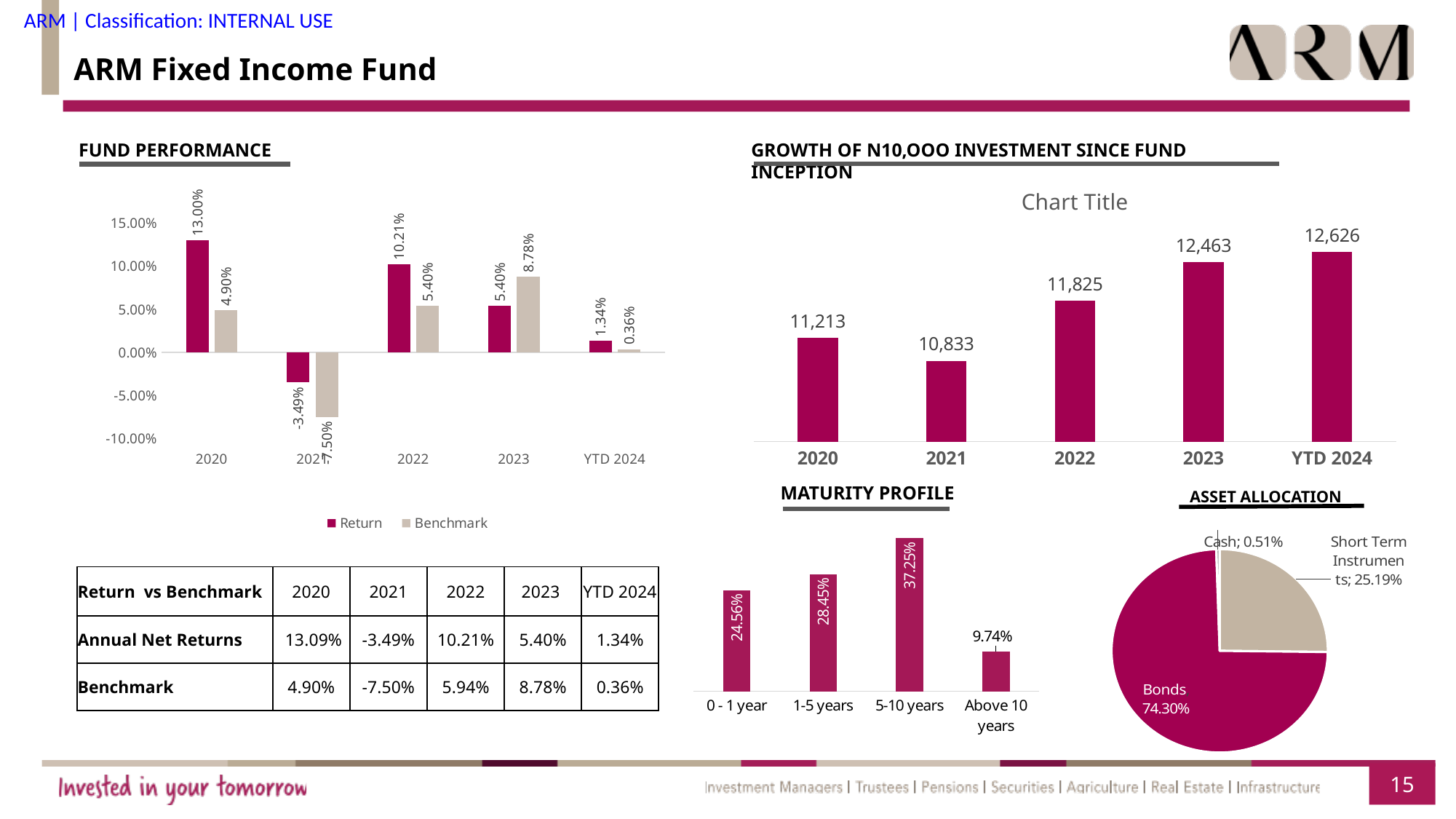
In the Growth of N10,000 Investment chart, which year has the lowest value? 2021 How many series does the legend of the Fund Performance chart list? 2 In the Growth of N10,000 Investment chart, what is the value for 2022? 11,825 In the Growth of N10,000 Investment chart, how many bars are plotted? 5 In the Maturity Profile chart, what is the difference between the 1-5 years value and the 0 - 1 year value? 3.89% In the Fund Performance chart, which is larger for 2023, the Return or the Benchmark? Benchmark In the Growth of N10,000 Investment chart, what is the difference between the YTD 2024 value and the 2023 value? 163 In the Asset Allocation pie chart, what share do Bonds have? 74.30% In the Maturity Profile chart, what is the value for 5-10 years? 37.25% What kind of chart is the Asset Allocation chart? Pie chart In the Maturity Profile chart, which category has the lowest value? Above 10 years In the Fund Performance chart, what is the Benchmark value for 2021? -7.50%